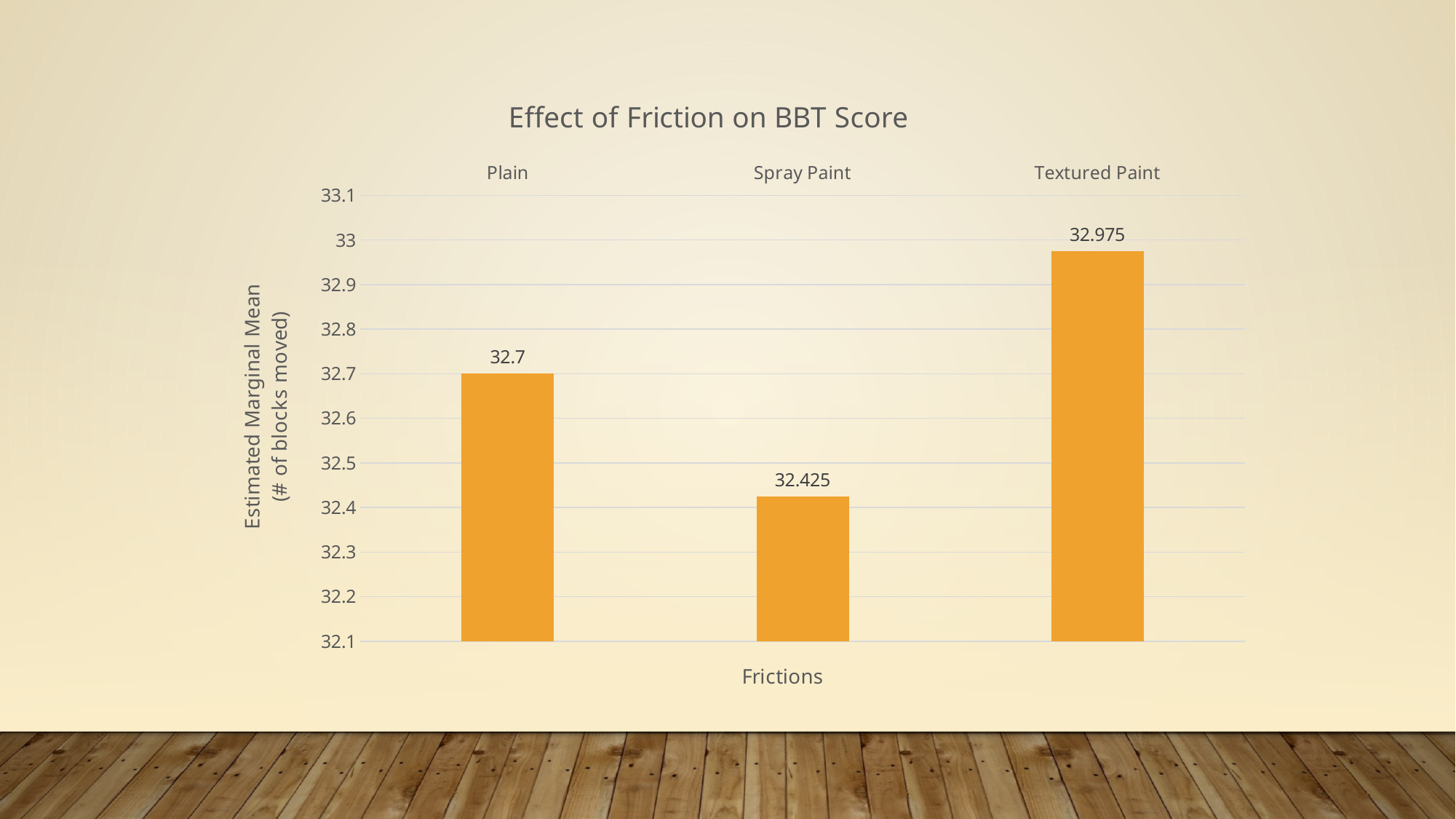
Which is larger, the value for Plain or the value for Spray Paint? Plain Is the value for Textured Paint greater or less than 33? less What kind of chart is shown on the slide? bar chart What is the difference between the Plain and Spray Paint values? 0.275 Which friction condition has the lowest estimated marginal mean? Spray Paint What is the estimated marginal mean for Plain? 32.7 What is the difference between the Textured Paint and Plain values? 0.275 Which friction condition has the highest estimated marginal mean? Textured Paint What is the title of the chart? Effect of Friction on BBT Score What is the estimated marginal mean for Textured Paint? 32.975 How many friction conditions are shown on the chart? 3 What is the estimated marginal mean for Spray Paint? 32.425